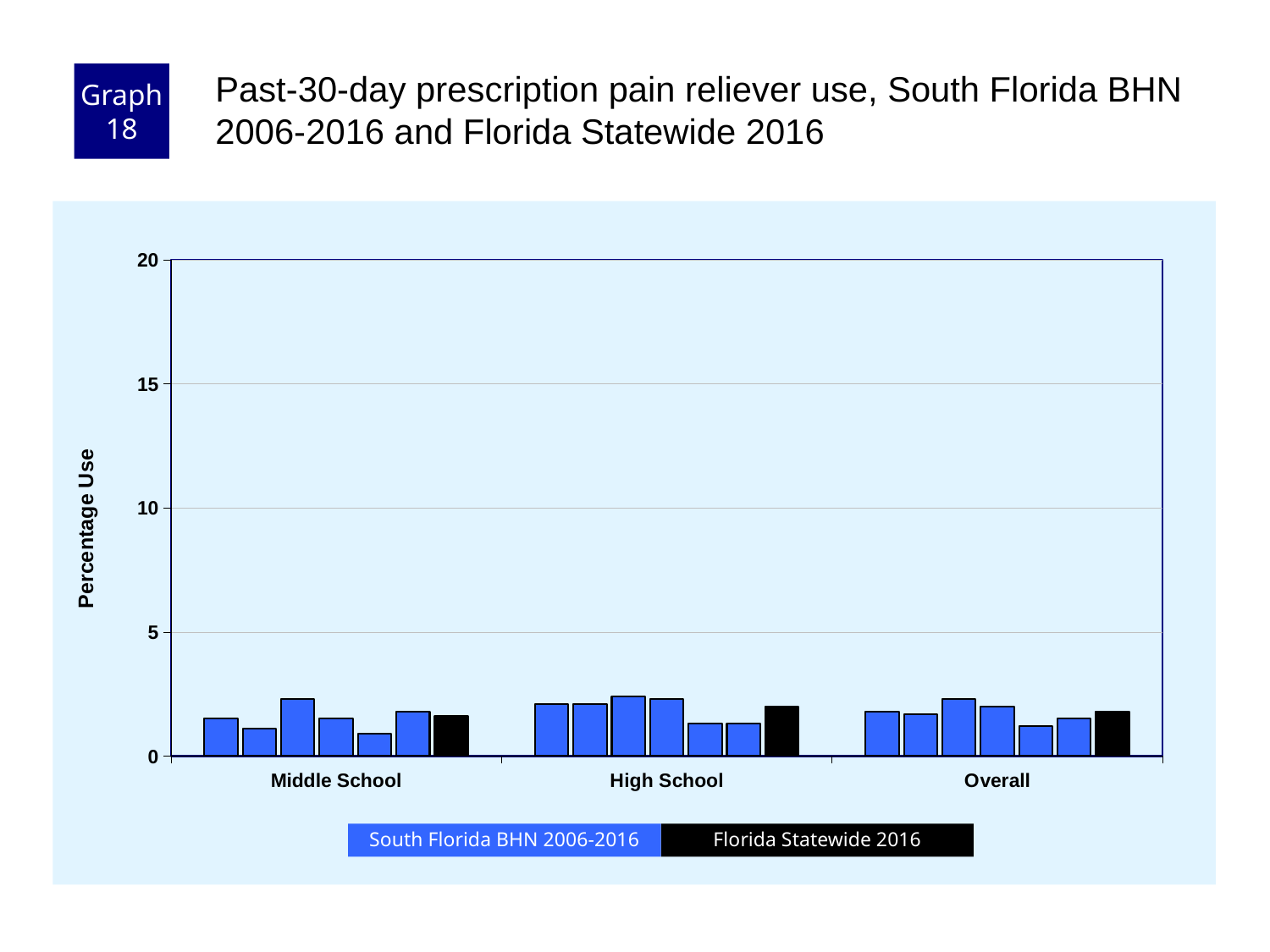
Is the Florida Statewide 2016 value for Overall greater or less than 10? less What is the label on the y axis? Percentage Use How many series does the legend list? 2 How many categories are shown along the x axis? 3 What kind of chart is shown on the slide? bar chart Are any of the South Florida BHN 2006-2016 bars for High School greater or less than 5? less What is the highest value shown on the y axis? 20 Is the Florida Statewide 2016 value for High School greater or less than 5? less Which series is shown in black in the legend? Florida Statewide 2016